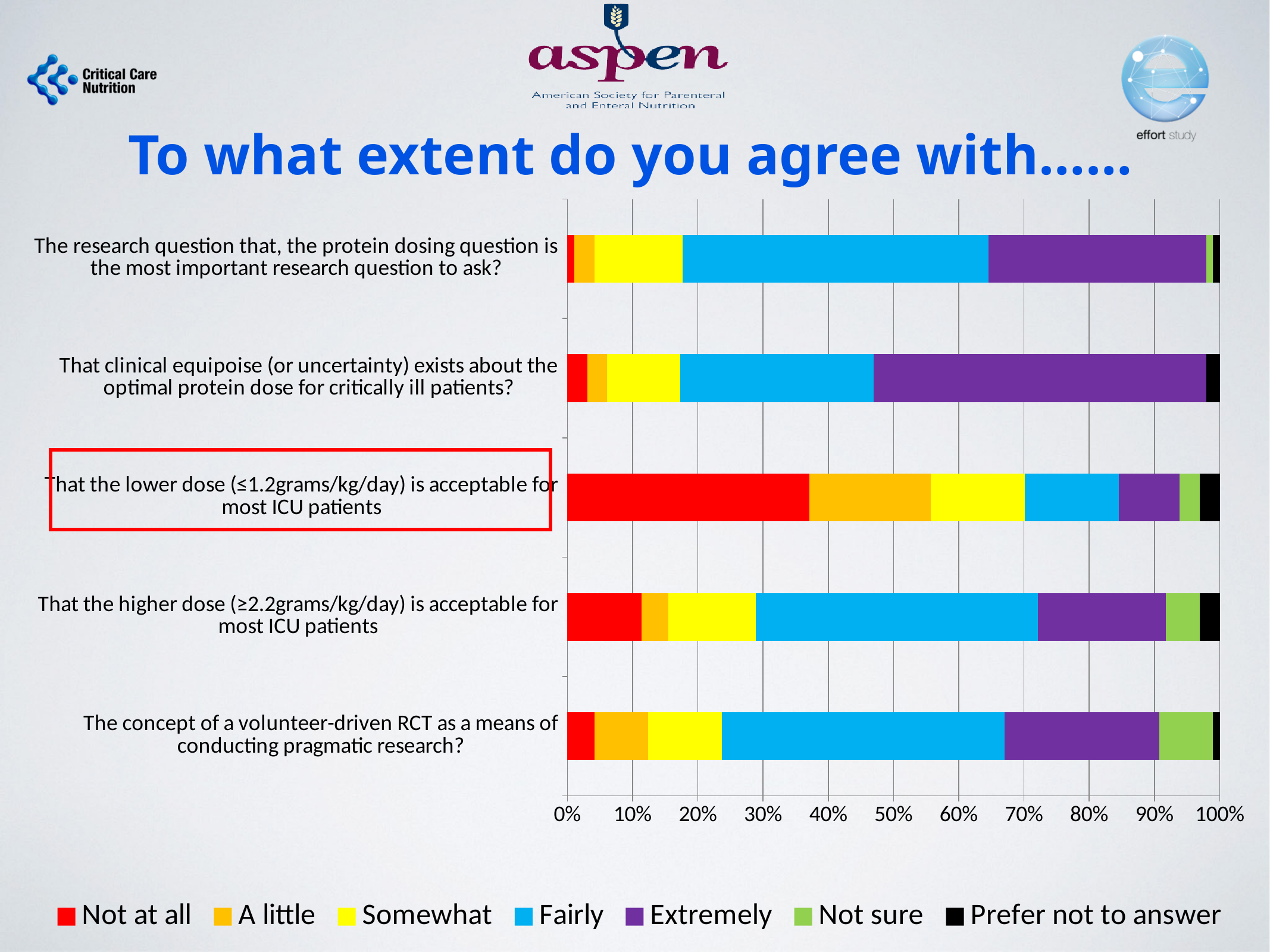
How many response options does the legend list? 7 What kind of chart is shown on the slide? Stacked bar chart Is the 'Not at all' share for 'That the lower dose (≤1.2grams/kg/day) is acceptable for most ICU patients' greater or less than 30%? greater What is the title of the slide above the chart? To what extent do you agree with…… How many statements (categories) are plotted in the chart? 5 Which statement has the largest 'Extremely' share? That clinical equipoise (or uncertainty) exists about the optimal protein dose for critically ill patients? Is the 'Not at all' share for 'That the higher dose (≥2.2grams/kg/day) is acceptable for most ICU patients' greater or less than 20%? less Which response option is shown in red in the legend? Not at all Is the 'Fairly' share larger for 'The research question that, the protein dosing question is the most important research question to ask?' or for 'That the lower dose (≤1.2grams/kg/day) is acceptable for most ICU patients'? The research question that, the protein dosing question is the most important research question to ask? Which statement has the smallest 'Extremely' share? That the lower dose (≤1.2grams/kg/day) is acceptable for most ICU patients Is the 'Extremely' share for 'That clinical equipoise (or uncertainty) exists about the optimal protein dose for critically ill patients?' greater or less than 40%? greater Which statement has the largest 'Not at all' share? That the lower dose (≤1.2grams/kg/day) is acceptable for most ICU patients